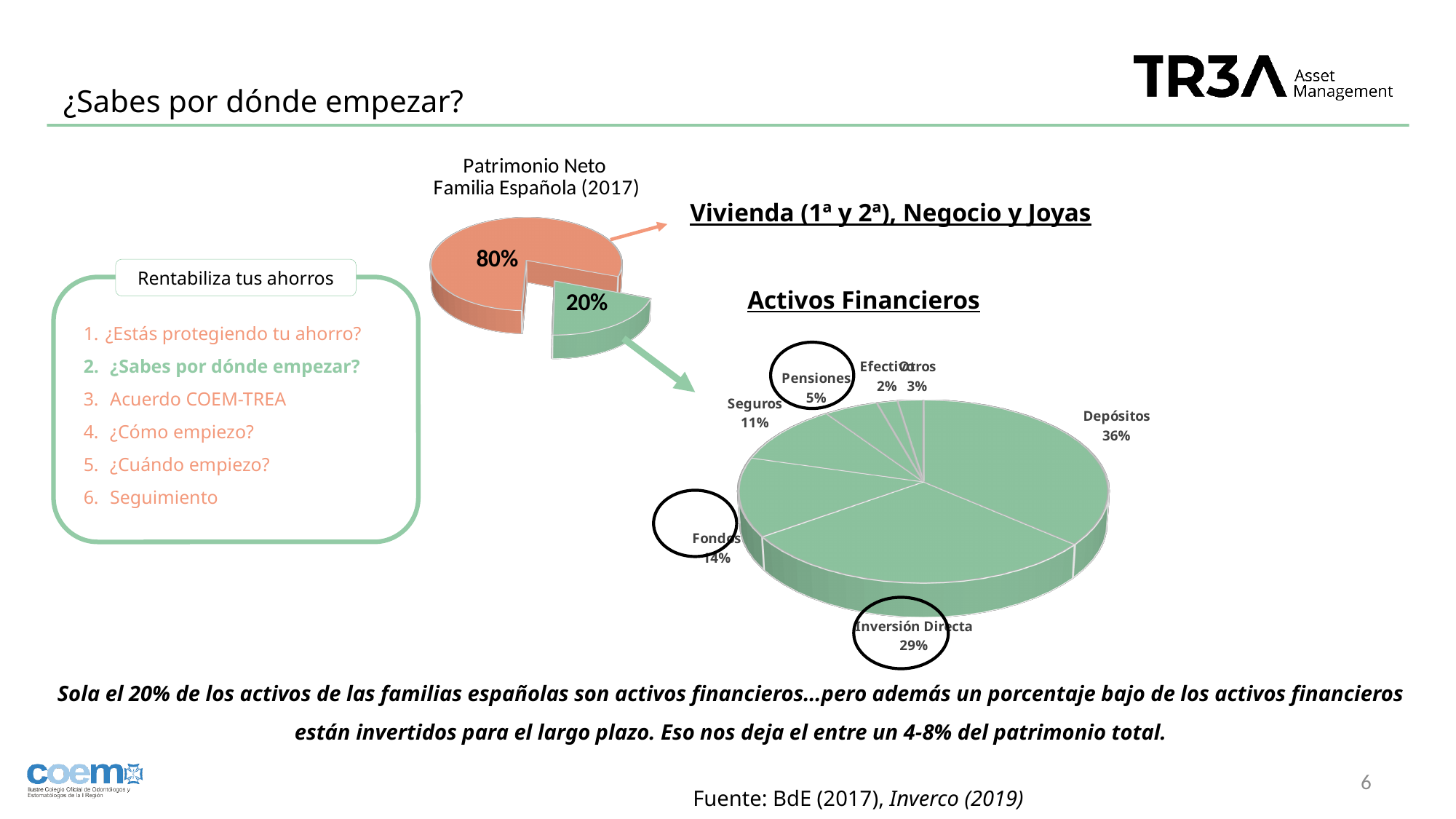
How many categories are shown in the Activos Financieros pie chart? 7 In the Activos Financieros chart, what percentage is shown for Depósitos? 36% In the Activos Financieros chart, what percentage is shown for Inversión Directa? 29% In the Patrimonio Neto Familia Española (2017) chart, what share is shown for Activos Financieros? 20% In the Activos Financieros chart, what is the difference in percentage points between Depósitos and Inversión Directa? 7 percentage points What kind of chart is the Patrimonio Neto Familia Española (2017) chart? Pie chart In the Patrimonio Neto Familia Española (2017) chart, what share of net wealth is shown for the larger slice (Vivienda, Negocio y Joyas)? 80% How many slices does the Patrimonio Neto Familia Española (2017) pie chart have? 2 In the Activos Financieros chart, what percentage is shown for Seguros? 11% In the Activos Financieros chart, what percentage is shown for Fondos? 14% In the Activos Financieros chart, which category has the largest share? Depósitos In the Activos Financieros chart, which category has the smallest share? Efectivo